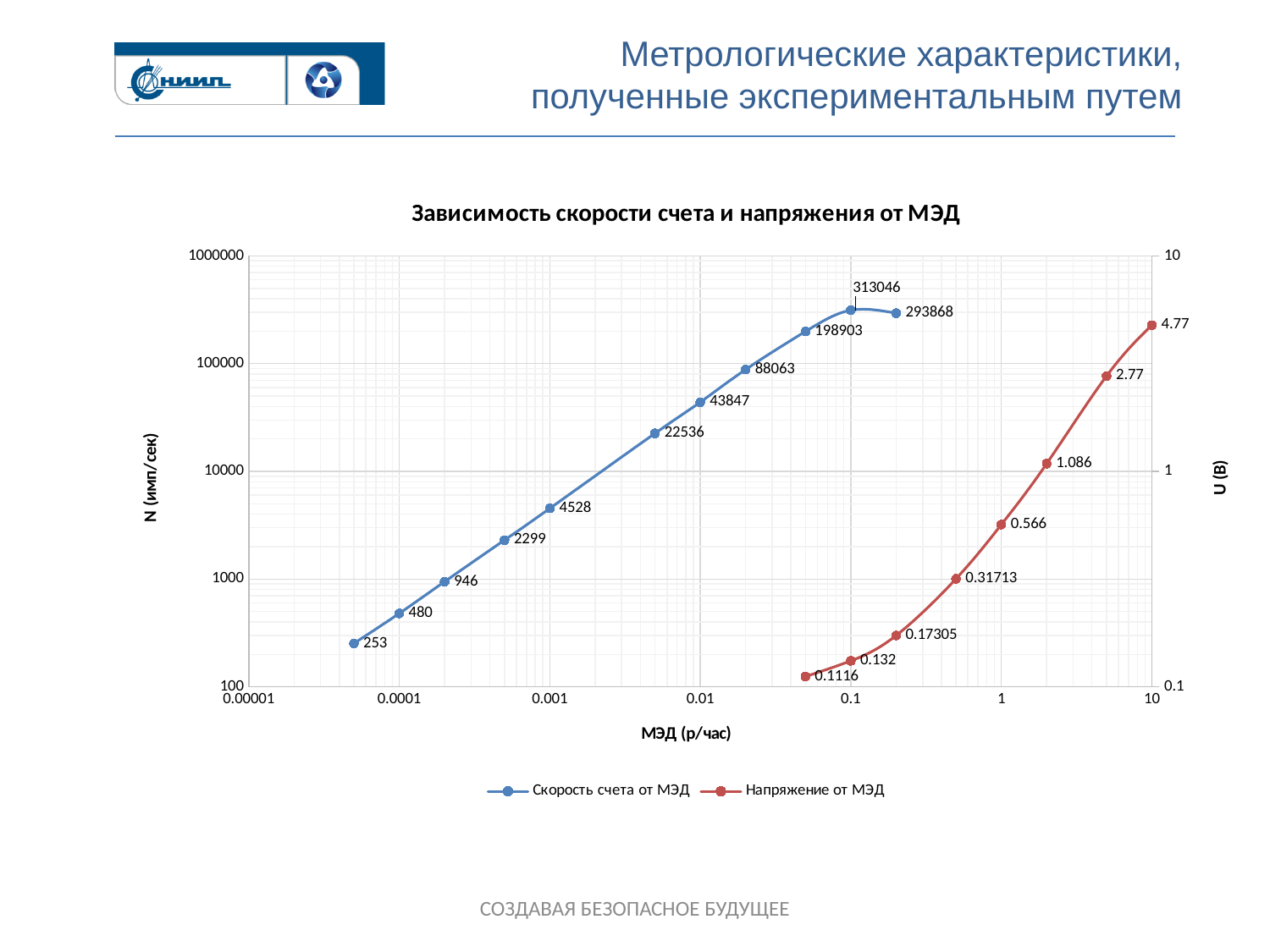
What kind of chart is shown on the slide? line chart What is the lowest labelled value of the series 'Скорость счета от МЭД'? 253 What is the difference between the two highest labelled values of 'Скорость счета от МЭД', 313046 and 293868? 19178 Does the series 'Напряжение от МЭД' rise or fall as МЭД increases along the x axis? rise What is the highest labelled value of the series 'Скорость счета от МЭД'? 313046 What is the lowest labelled value of the series 'Напряжение от МЭД'? 0.1116 How many data points are plotted for the series 'Напряжение от МЭД'? 8 How many series does the legend list? 2 What is the value of 'Скорость счета от МЭД' at МЭД = 0.01 р/час? 43847 What is the highest labelled value of the series 'Напряжение от МЭД'? 4.77 What is the value of 'Напряжение от МЭД' at МЭД = 1 р/час? 0.566 What is the title of the chart? Зависимость скорости счета и напряжения от МЭД